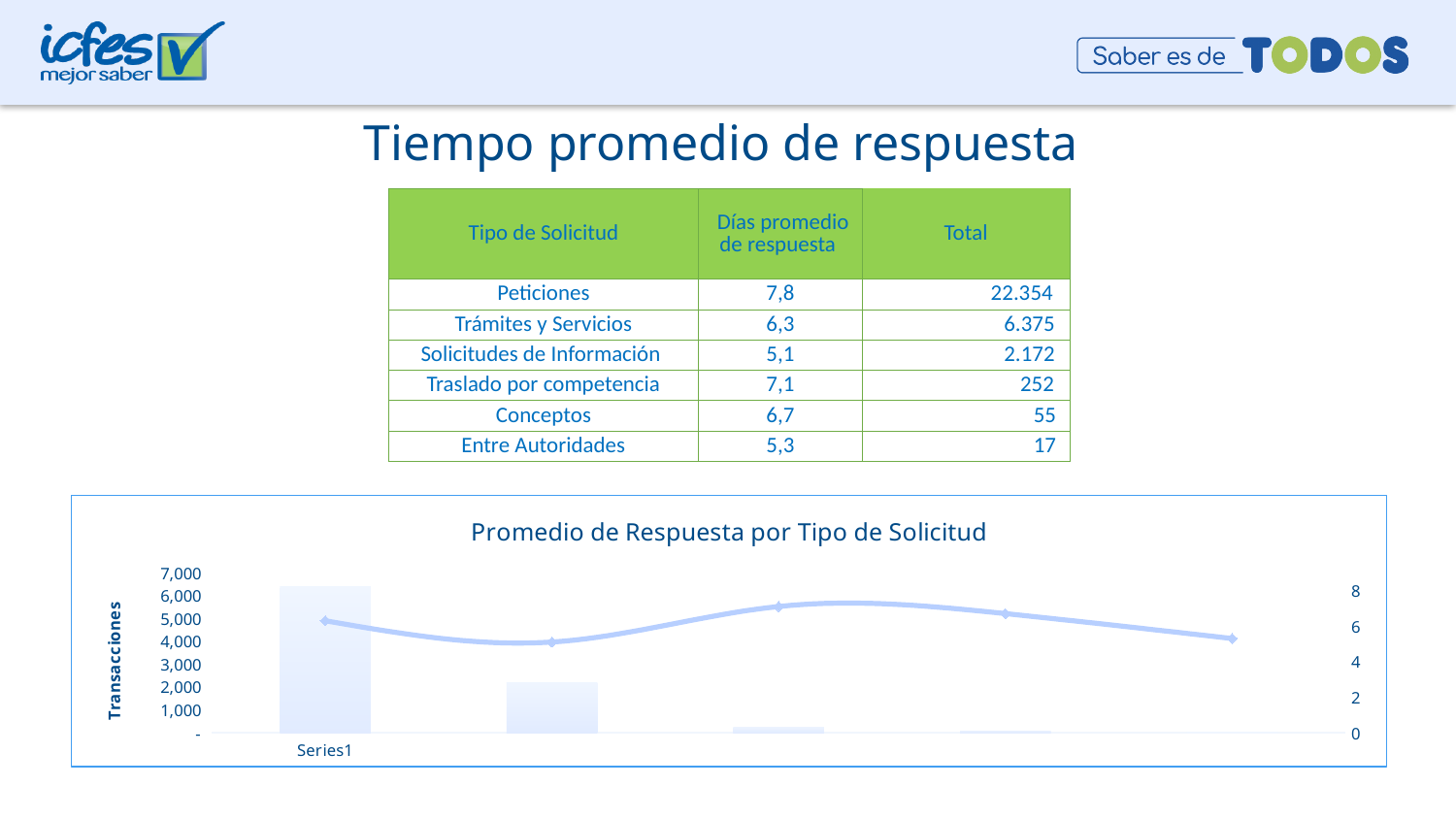
Is the second point on the line greater or less than 6 on the right axis? less What kind of chart is shown on the slide? A combined bar and line chart How many data points (markers) does the line in the chart have? 5 Which bar in the chart is the tallest? The first bar (leftmost) What is the title of the chart on the slide? Promedio de Respuesta por Tipo de Solicitud Is the third point on the line greater or less than 6 on the right axis? greater Is the value of the third bar greater or less than 1,000 on the left axis? less Which is taller, the first bar or the second bar? The first bar What is the title of the left vertical axis of the chart? Transacciones Which point on the line is the highest? The third point